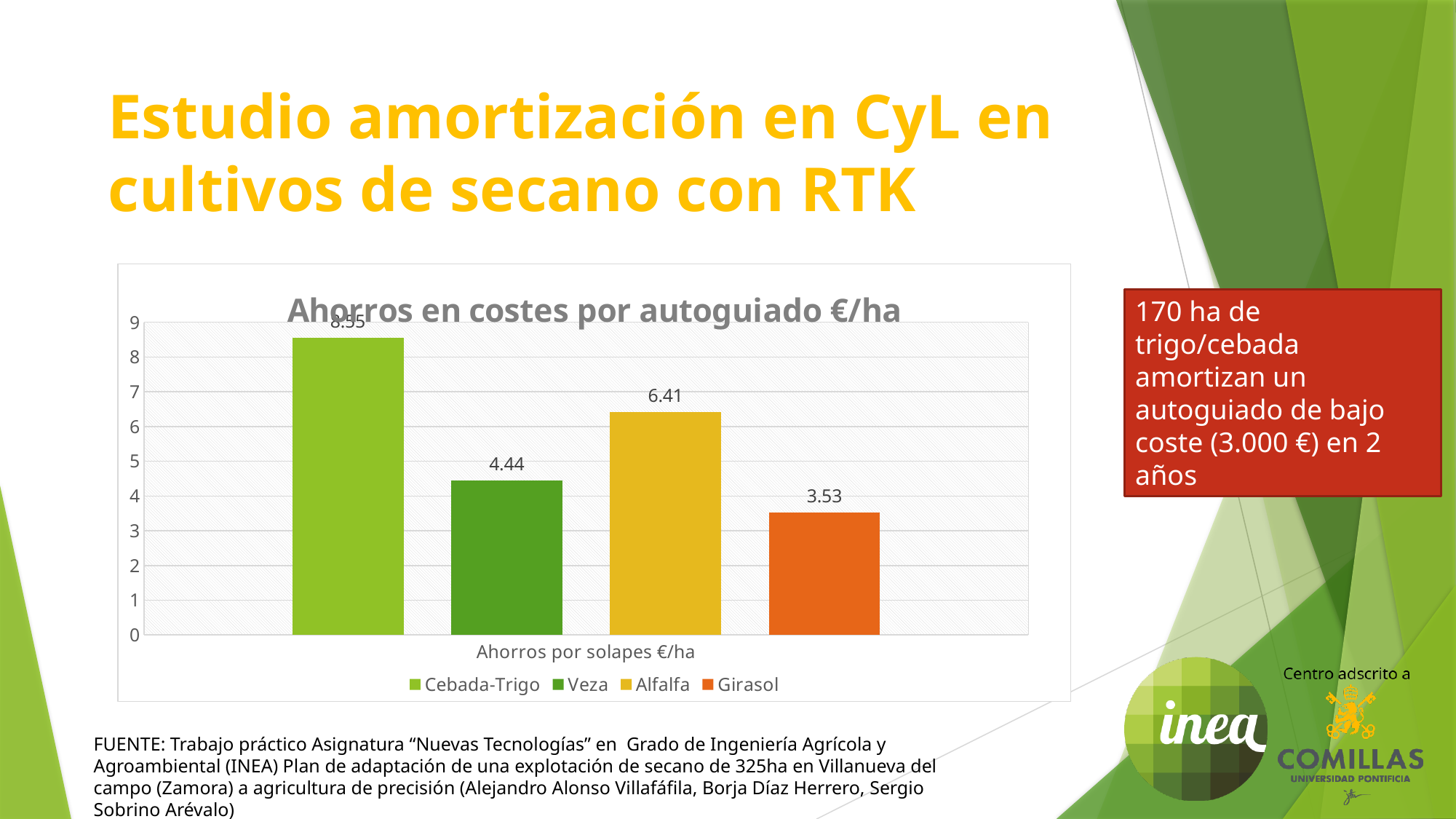
What kind of chart is shown on the slide? Bar chart What is the value for Veza in the chart? 4.44 What is the value for Cebada-Trigo in the chart? 8.55 What is the difference between the values for Alfalfa and Veza? 1.97 Which series has the highest value in the chart? Cebada-Trigo Which is larger, the value for Veza or the value for Girasol? Veza Which series has the lowest value in the chart? Girasol What is the value for Alfalfa in the chart? 6.41 Is the value for Cebada-Trigo greater or less than 8? greater What is the value for Girasol in the chart? 3.53 How many series does the legend list? 4 What is the title of the chart? Ahorros en costes por autoguiado €/ha